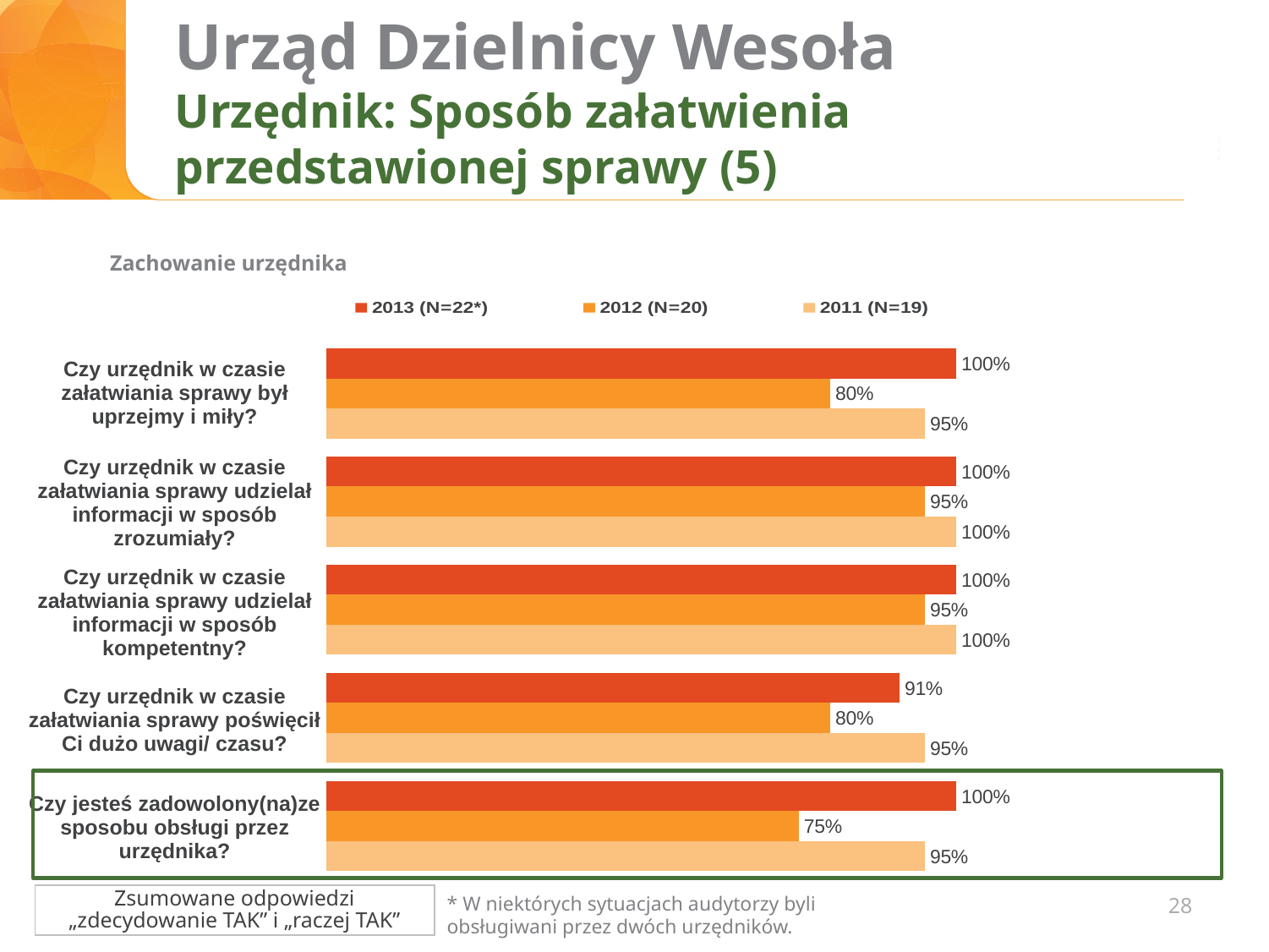
What is the difference between the 2013 and 2012 values for "Czy jesteś zadowolony(na) ze sposobu obsługi przez urzędnika?"? 25% What type of chart is shown on the slide? bar chart For "Czy urzędnik w czasie załatwiania sprawy poświęcił Ci dużo uwagi/ czasu?", which is larger: the 2013 value or the 2011 value? 2011 (N=19) What is the 2012 (N=20) value for "Czy jesteś zadowolony(na) ze sposobu obsługi przez urzędnika?"? 75% What is the 2012 (N=20) value for "Czy urzędnik w czasie załatwiania sprawy udzielał informacji w sposób zrozumiały?"? 95% How many series does the chart legend list? 3 What is the 2013 (N=22*) value for "Czy urzędnik w czasie załatwiania sprawy poświęcił Ci dużo uwagi/ czasu?"? 91% How many question categories are shown in the chart? 5 Which year has the lowest value for "Czy jesteś zadowolony(na) ze sposobu obsługi przez urzędnika?"? 2012 (N=20) What is the 2011 (N=19) value for "Czy urzędnik w czasie załatwiania sprawy był uprzejmy i miły?"? 95% What is the difference between the 2011 and 2012 values for "Czy urzędnik w czasie załatwiania sprawy był uprzejmy i miły?"? 15% What is the title shown above the chart? Zachowanie urzędnika